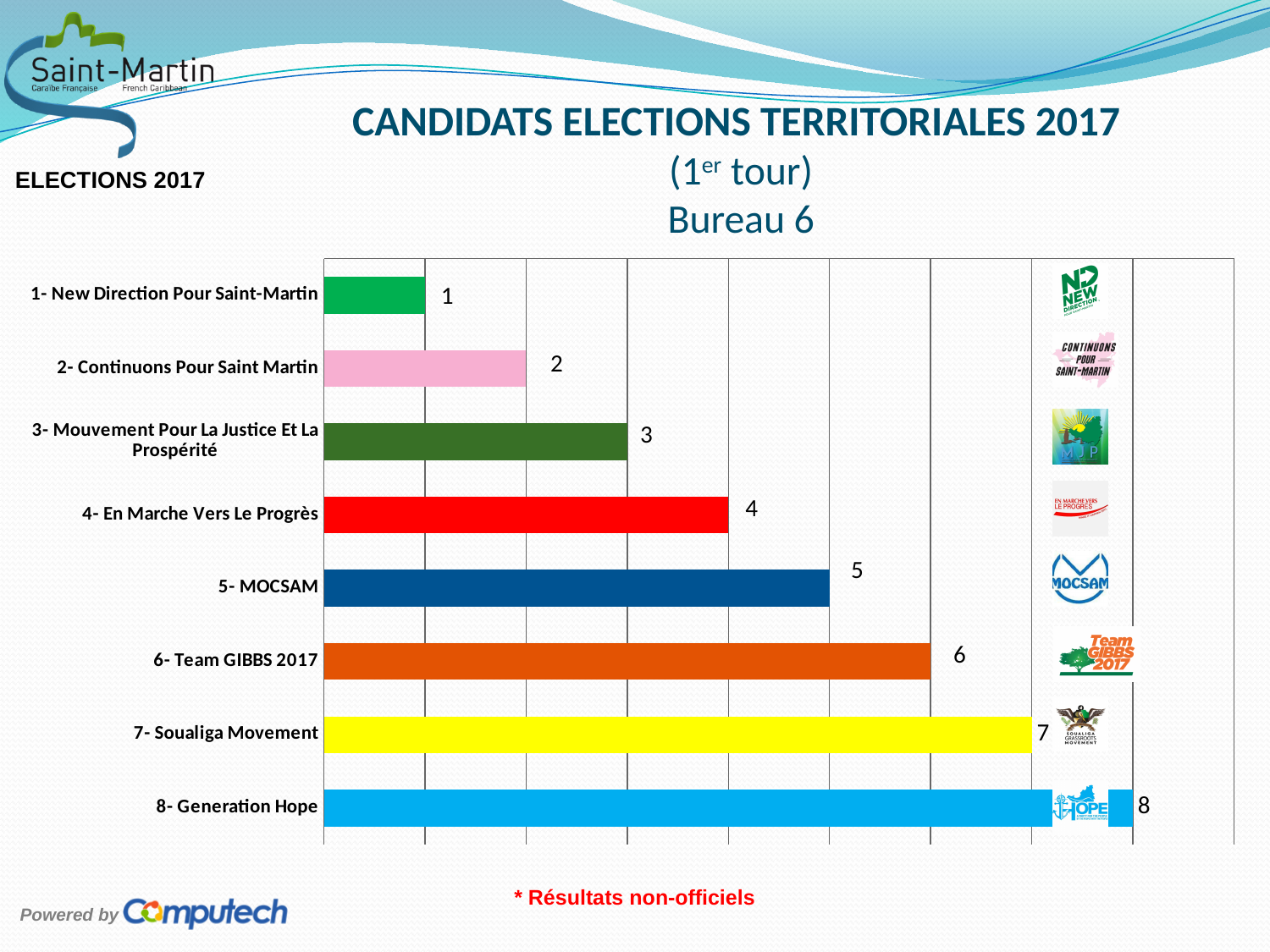
What colour is the bar for 4- En Marche Vers Le Progrès? Red What value is shown for 7- Soualiga Movement? 7 What is the difference between the values for 6- Team GIBBS 2017 and 3- Mouvement Pour La Justice Et La Prospérité? 3 What value is shown for 5- MOCSAM? 5 Which has a larger value, 4- En Marche Vers Le Progrès or 2- Continuons Pour Saint Martin? 4- En Marche Vers Le Progrès How many categories are shown in the chart? 8 Which category has the highest value? 8- Generation Hope What is the title of the chart? CANDIDATS ELECTIONS TERRITORIALES 2017 (1er tour) Bureau 6 What value is shown for 2- Continuons Pour Saint Martin? 2 What kind of chart is shown on the slide? Bar chart Do the values increase or decrease going down the list of categories from top to bottom? Increase Which category has the lowest value? 1- New Direction Pour Saint-Martin